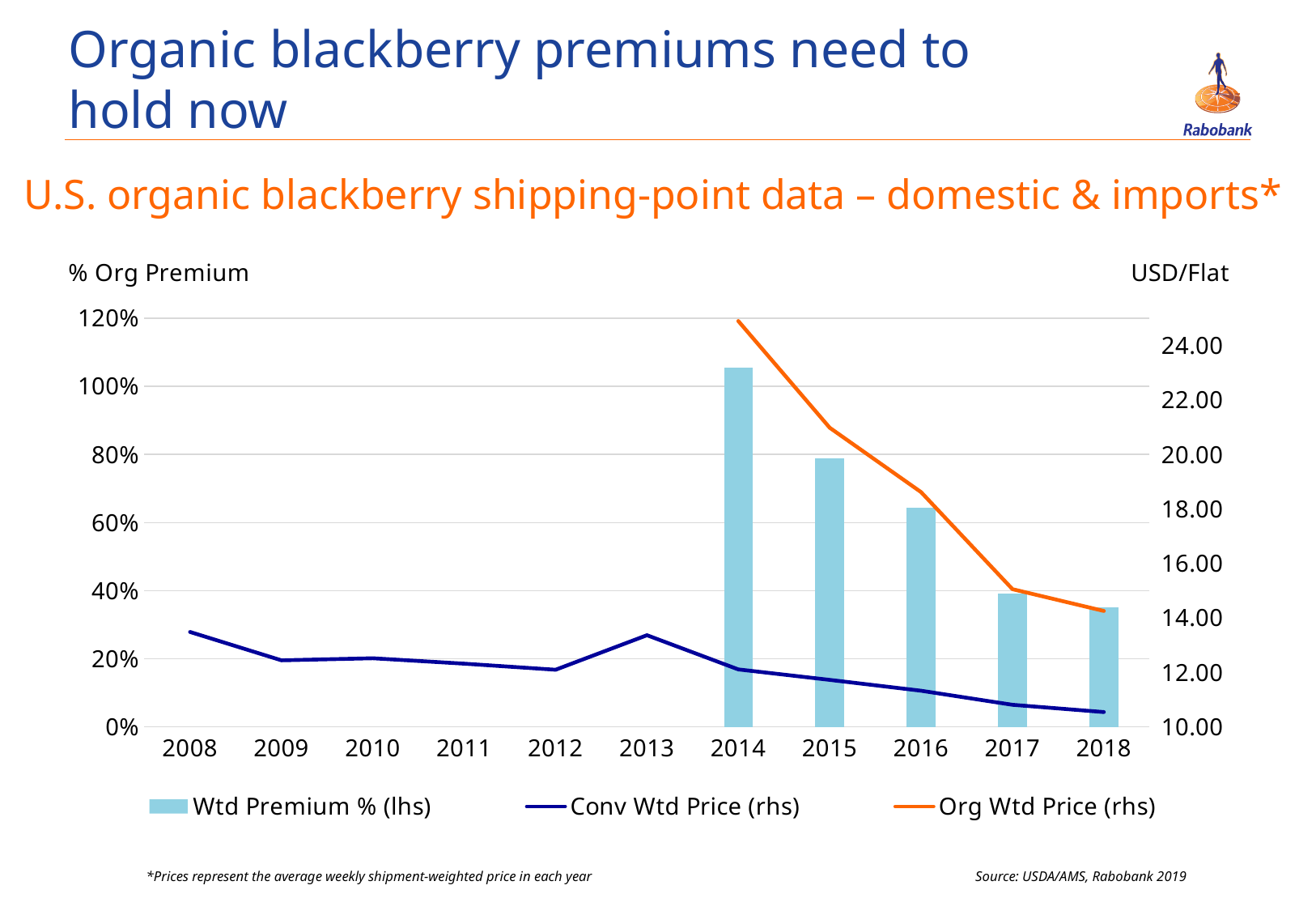
Which year has the highest Wtd Premium % bar? 2014 Is the Wtd Premium % for 2014 greater or less than 100%? greater Does the Org Wtd Price rise or fall from 2014 to 2018? It falls Is the Org Wtd Price for 2014 greater or less than 24.00? greater How many years are shown on the x axis? 11 What kind of chart is shown on the slide? A combined bar and line chart How many years have a Wtd Premium % bar plotted? 5 How many series does the legend list? 3 What is the label of the right-hand axis? USD/Flat Is the Conv Wtd Price for 2018 greater or less than 12.00? less Which year has the higher Conv Wtd Price, 2012 or 2013? 2013